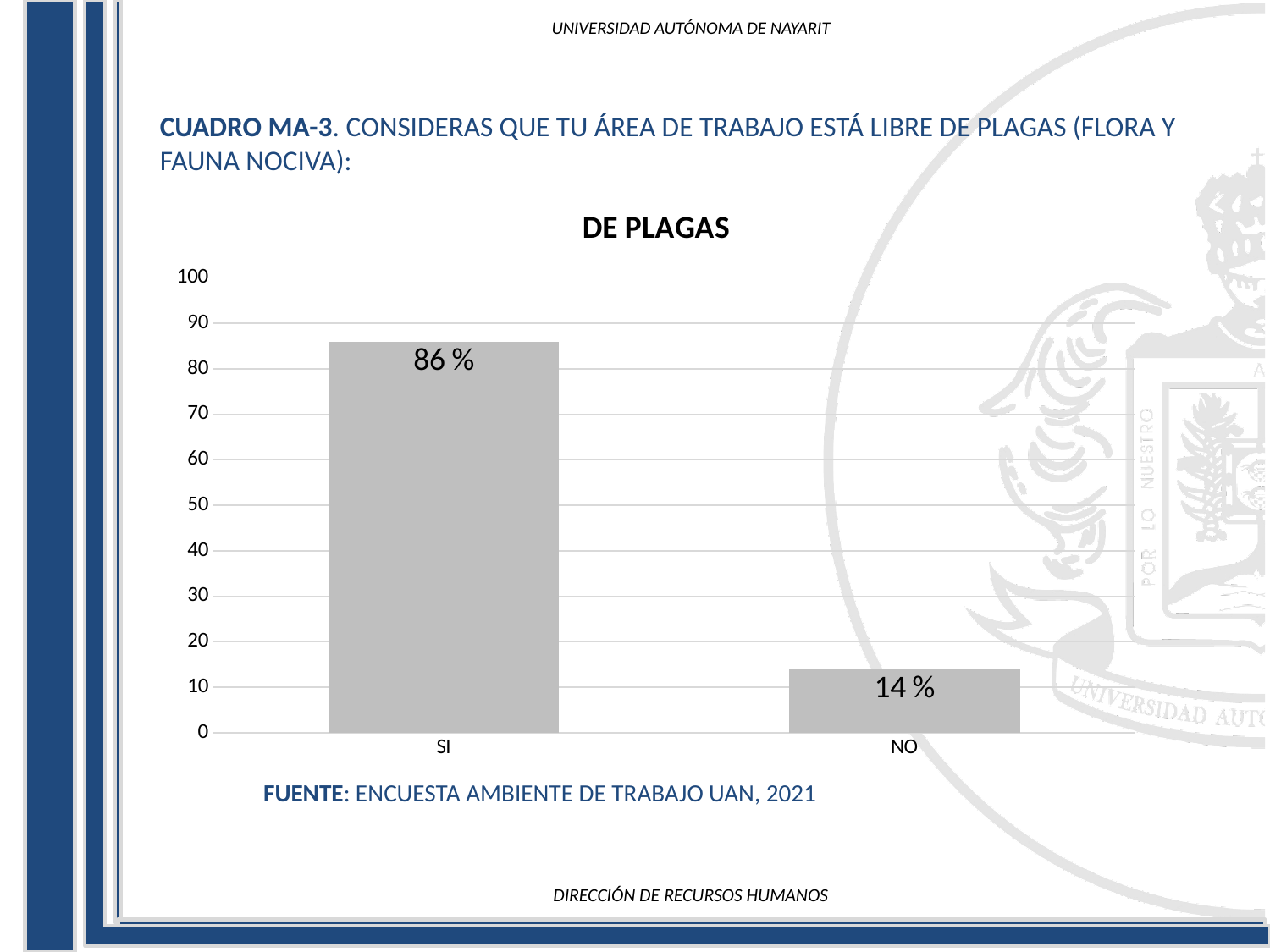
What is the value for NO? 14 % How many categories are shown on the x axis? 2 Which category has the highest value? SI What is the value for SI? 86 % Is the value for SI greater or less than 80? greater Is the value for NO greater or less than 20? less What is the difference between the values for SI and NO? 72 % What kind of chart is shown? bar chart What is the highest value shown on the y axis? 100 Which category has the lowest value? NO Which is larger, the value for SI or the value for NO? SI What is the title of the chart? DE PLAGAS